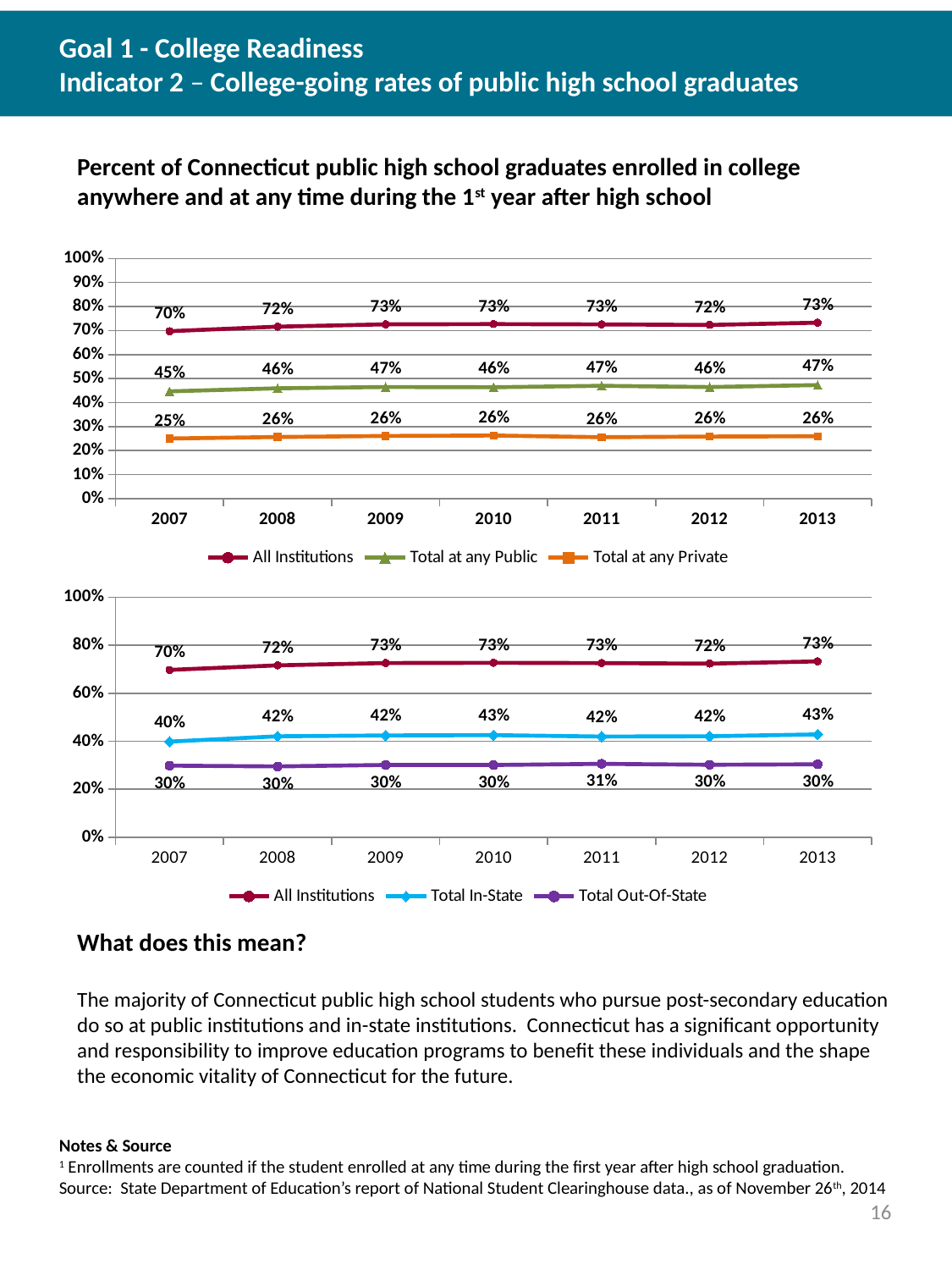
In the top chart, what is the difference between All Institutions and Total at any Public in 2013? 26% How many years are shown on the x axis of the top chart? 7 In the top chart, what is the value for Total at any Private in 2007? 25% In the top chart, in which year is the All Institutions value lowest? 2007 In the top chart, what is the value for Total at any Public in 2009? 47% In the top chart, is the value for Total at any Private in 2010 greater or less than 30%? less What kind of chart is the top chart? Line chart In the bottom chart, what is the difference between Total In-State and Total Out-Of-State in 2007? 10% How many series does the legend of the bottom chart list? 3 In the bottom chart, which is larger in 2012: Total In-State or Total Out-Of-State? Total In-State In the bottom chart, what is the value for Total Out-Of-State in 2011? 31% In the bottom chart, what is the value for Total In-State in 2010? 43%